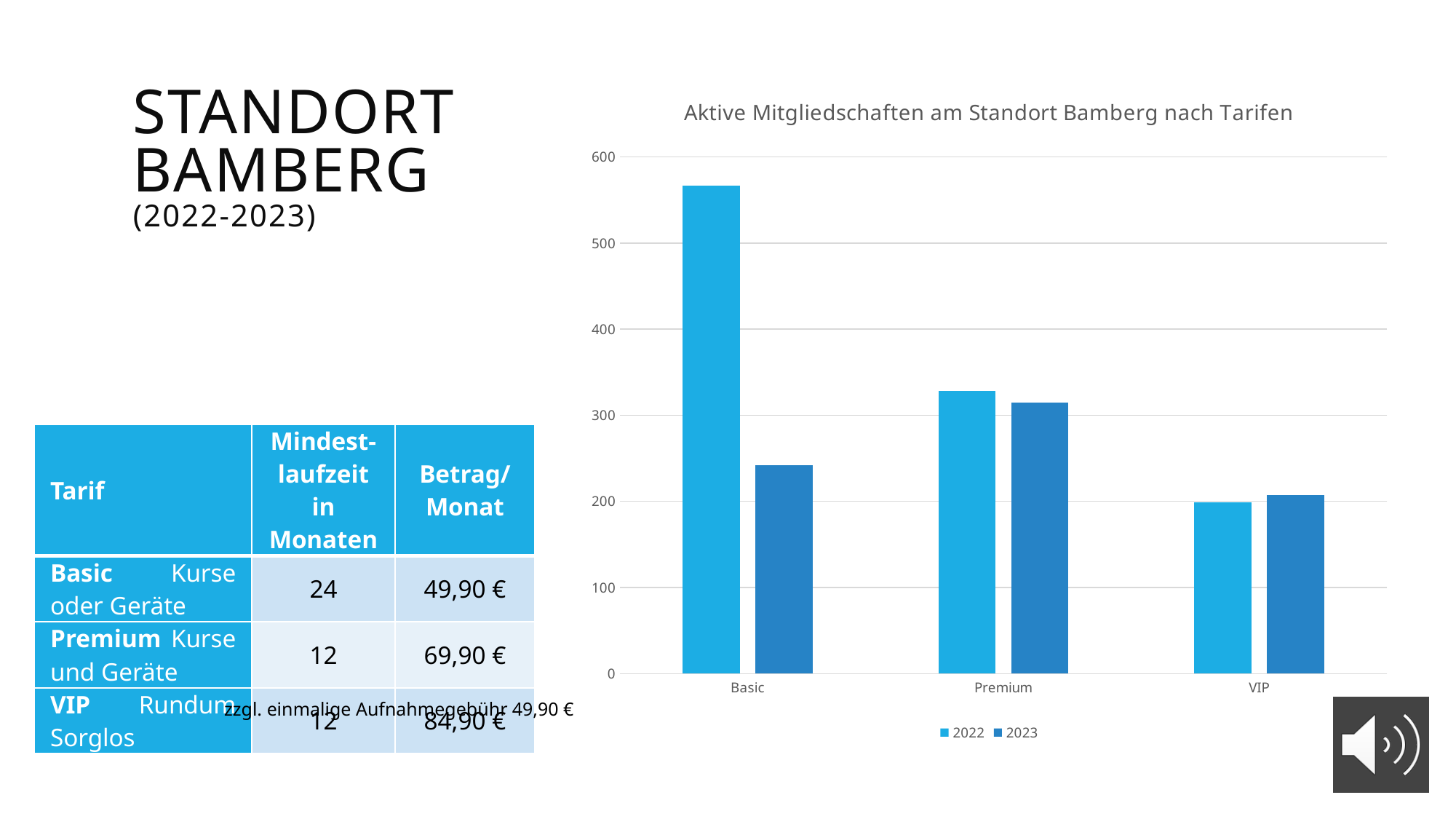
Which tariff has the highest value for 2023? Premium For the Basic tariff, which year has the larger value, 2022 or 2023? 2022 What kind of chart is shown on the slide? bar chart How many series does the chart legend list? 2 How many tariff categories are shown on the x axis of the chart? 3 Which tariff has the lowest value for 2022? VIP Is the value for Basic in 2023 greater or less than 300? less Is the value for Basic in 2022 greater or less than 500? greater Do the 2022 values rise or fall from Basic to VIP along the x axis? fall What is the title of the chart? Aktive Mitgliedschaften am Standort Bamberg nach Tarifen Which tariff has the lowest value for 2023? VIP Which tariff has the highest value for 2022? Basic